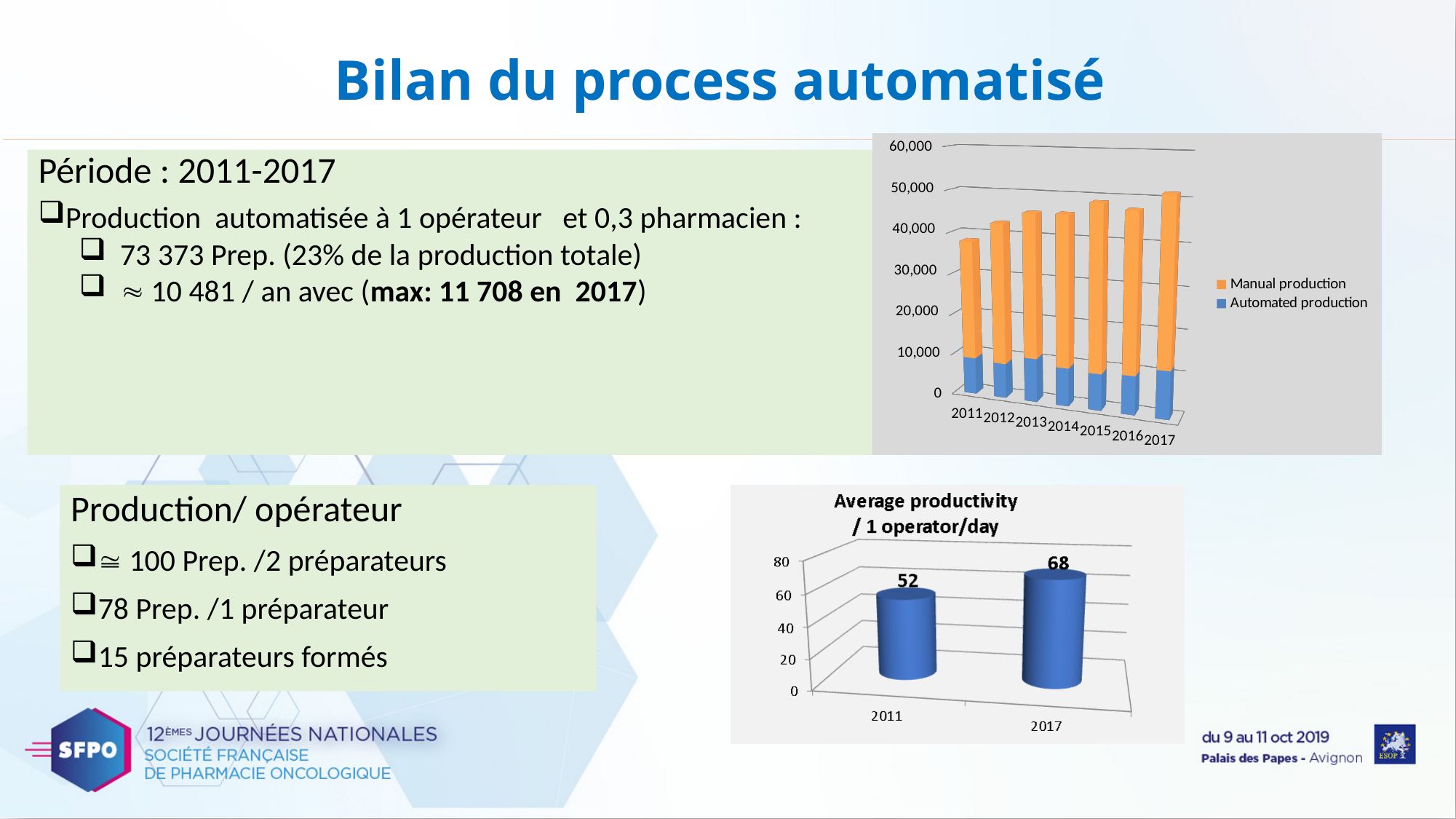
In the top-right production chart, which year has the lowest total bar? 2011 In the 'Average productivity / 1 operator/day' chart, what is the value for 2011? 52 In the 'Average productivity / 1 operator/day' chart, what is the difference between the 2017 and 2011 values? 16 In the top-right production chart, is the total bar for 2011 greater or less than 40,000? less How many series does the legend of the top-right production chart list? 2 In the 'Average productivity / 1 operator/day' chart, what is the value for 2017? 68 In the 'Average productivity / 1 operator/day' chart, which year has the higher value? 2017 In the top-right production chart, which year has the highest total bar? 2017 What kind of chart is the 'Average productivity / 1 operator/day' chart? bar chart In the top-right production chart, which series is shown in orange? Manual production How many categories are shown in the 'Average productivity / 1 operator/day' chart? 2 How many years are shown on the x axis of the top-right production chart? 7